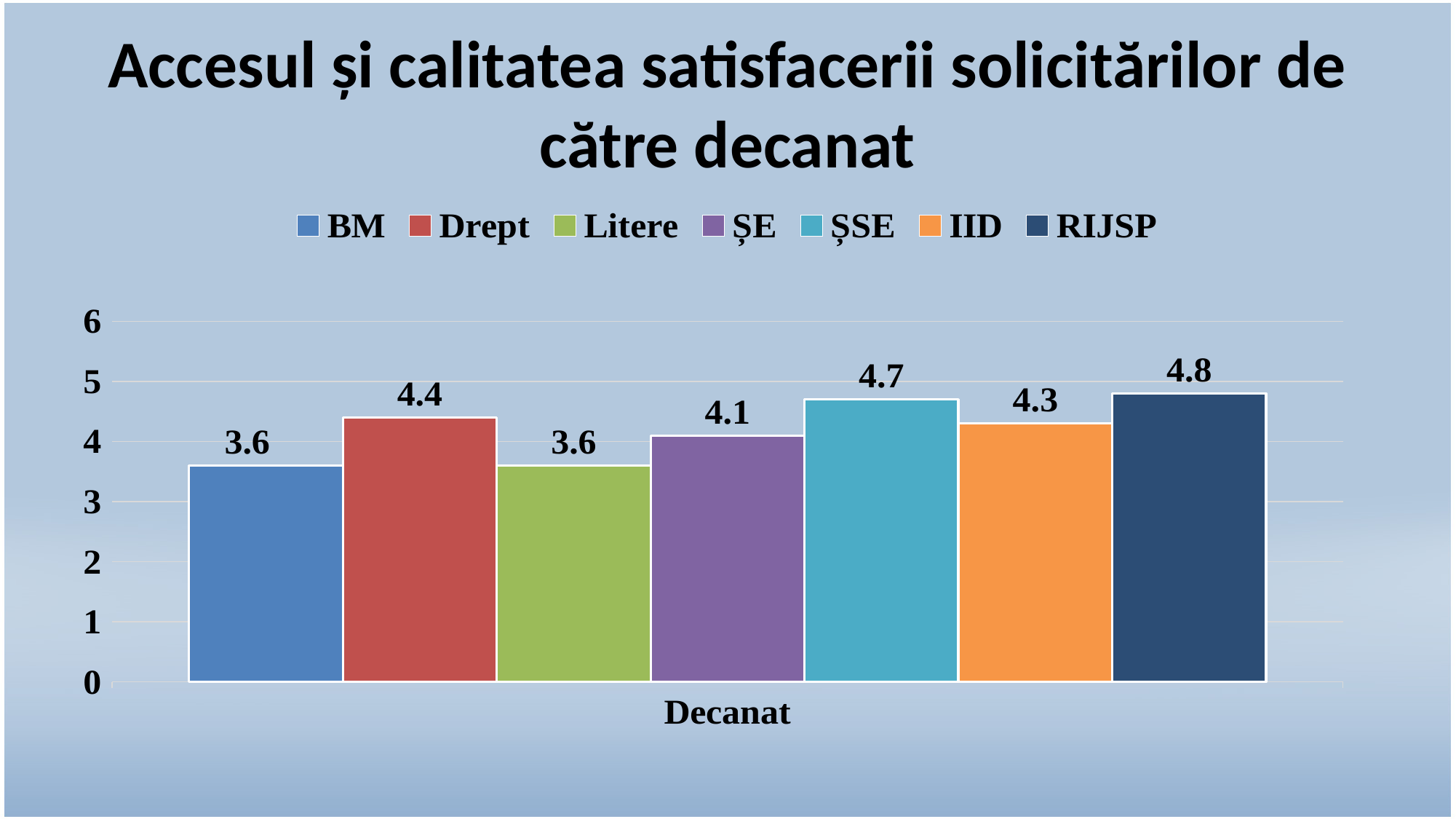
Which is larger, the value for Drept or the value for IID? Drept Is the value for ȘE greater or less than 4? greater What is the difference between the values for RIJSP and BM? 1.2 Which two series share the same value of 3.6? BM and Litere What is the value for IID? 4.3 How many series does the legend list? 7 What is the value for ȘSE? 4.7 Which series has the highest value? RIJSP What is the value for Drept? 4.4 What kind of chart is shown on the slide? bar chart What is the difference between the values for ȘSE and ȘE? 0.6 What is the label on the x axis? Decanat